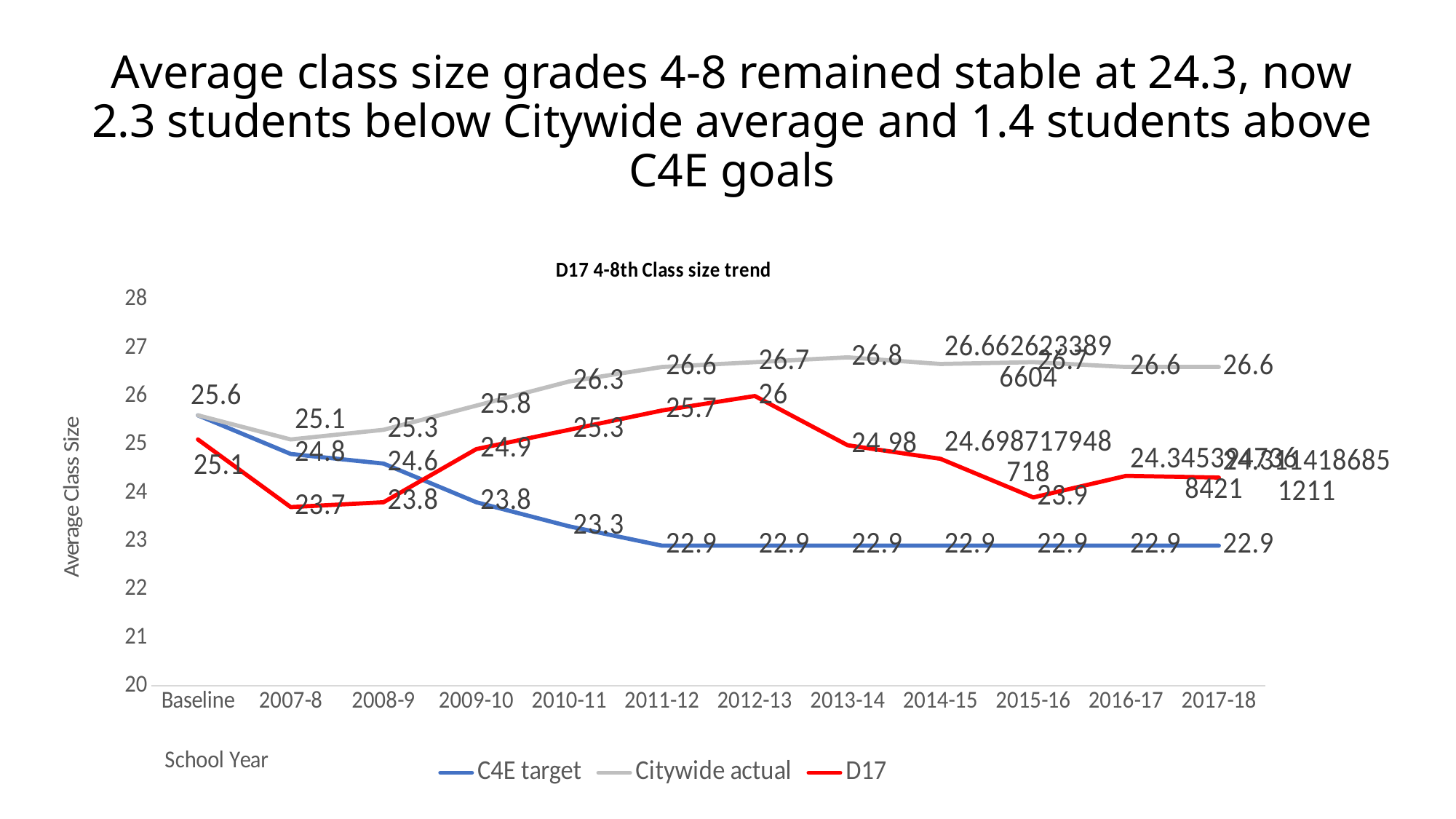
What is the Citywide actual value for 2010-11? 26.3 In which school year does the D17 series reach its highest value? 2012-13 What is the D17 value for 2007-8? 23.7 What is the C4E target value for 2011-12? 22.9 What is the D17 value for 2012-13? 26 In which school year does the D17 series have its lowest value? 2007-8 What is the difference between the Citywide actual and the C4E target values in 2013-14? 3.9 What kind of chart is shown on the slide? Line chart How many series does the legend list? 3 What is the Citywide actual value for 2013-14? 26.8 In 2009-10, which is larger: the D17 value or the C4E target value? D17 How many school years are shown on the x axis? 12